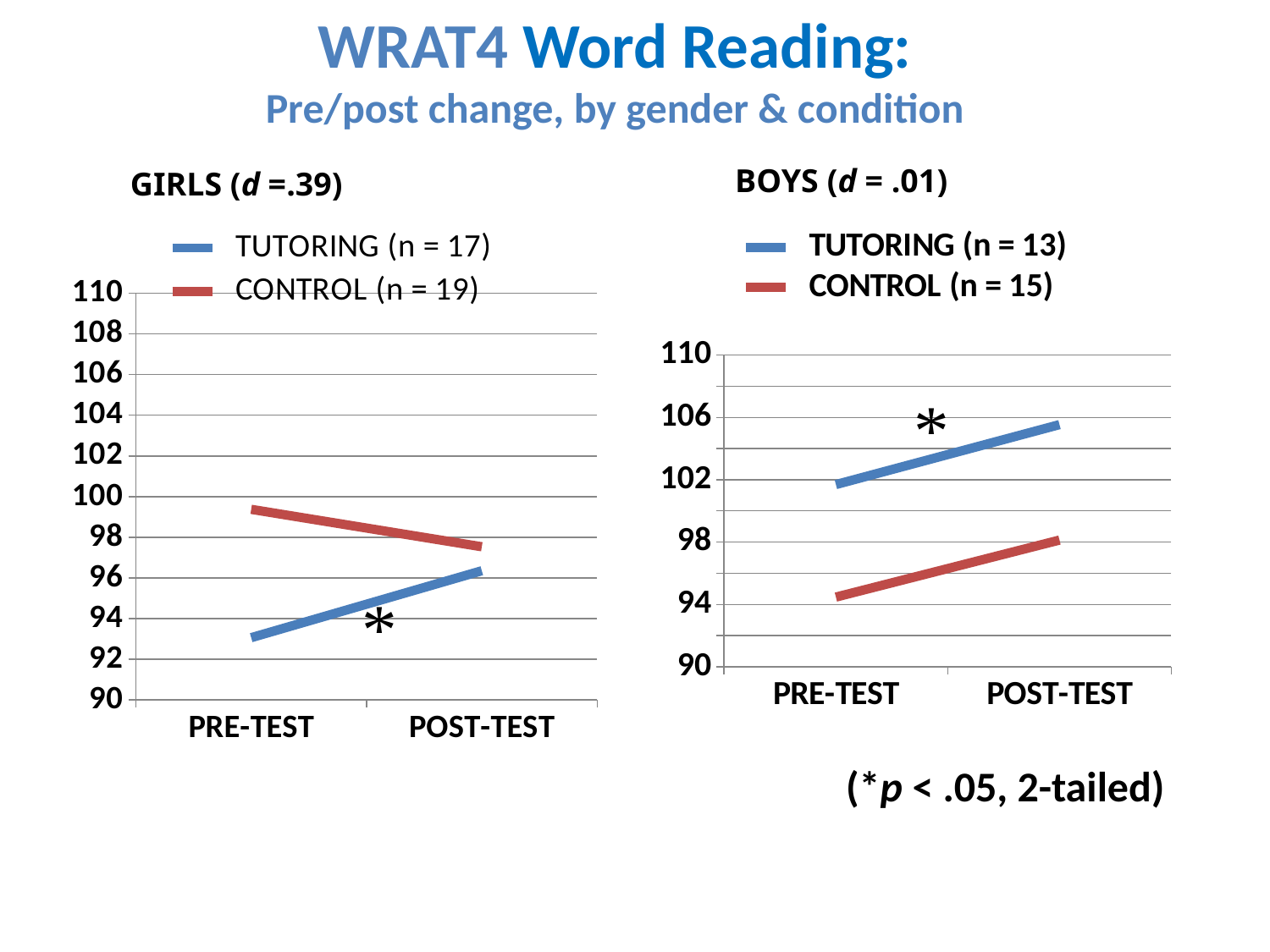
In the GIRLS chart, does the CONTROL line rise or fall from PRE-TEST to POST-TEST? fall In the BOYS chart, is the CONTROL value at PRE-TEST greater or less than 98? less In the BOYS chart, does the CONTROL line rise or fall from PRE-TEST to POST-TEST? rise What kind of chart is the GIRLS chart? line chart In the GIRLS chart, is the CONTROL value at PRE-TEST greater or less than 98? greater In the BOYS chart, is the TUTORING value at POST-TEST greater or less than 102? greater In the BOYS chart, which group has the higher value at POST-TEST, TUTORING or CONTROL? TUTORING In the GIRLS chart, what is the sample size shown in the legend for the CONTROL group? n = 19 In the GIRLS chart, which group has the higher value at PRE-TEST, TUTORING or CONTROL? CONTROL In the GIRLS chart, does the TUTORING line rise or fall from PRE-TEST to POST-TEST? rise How many series does the legend of the BOYS chart list? 2